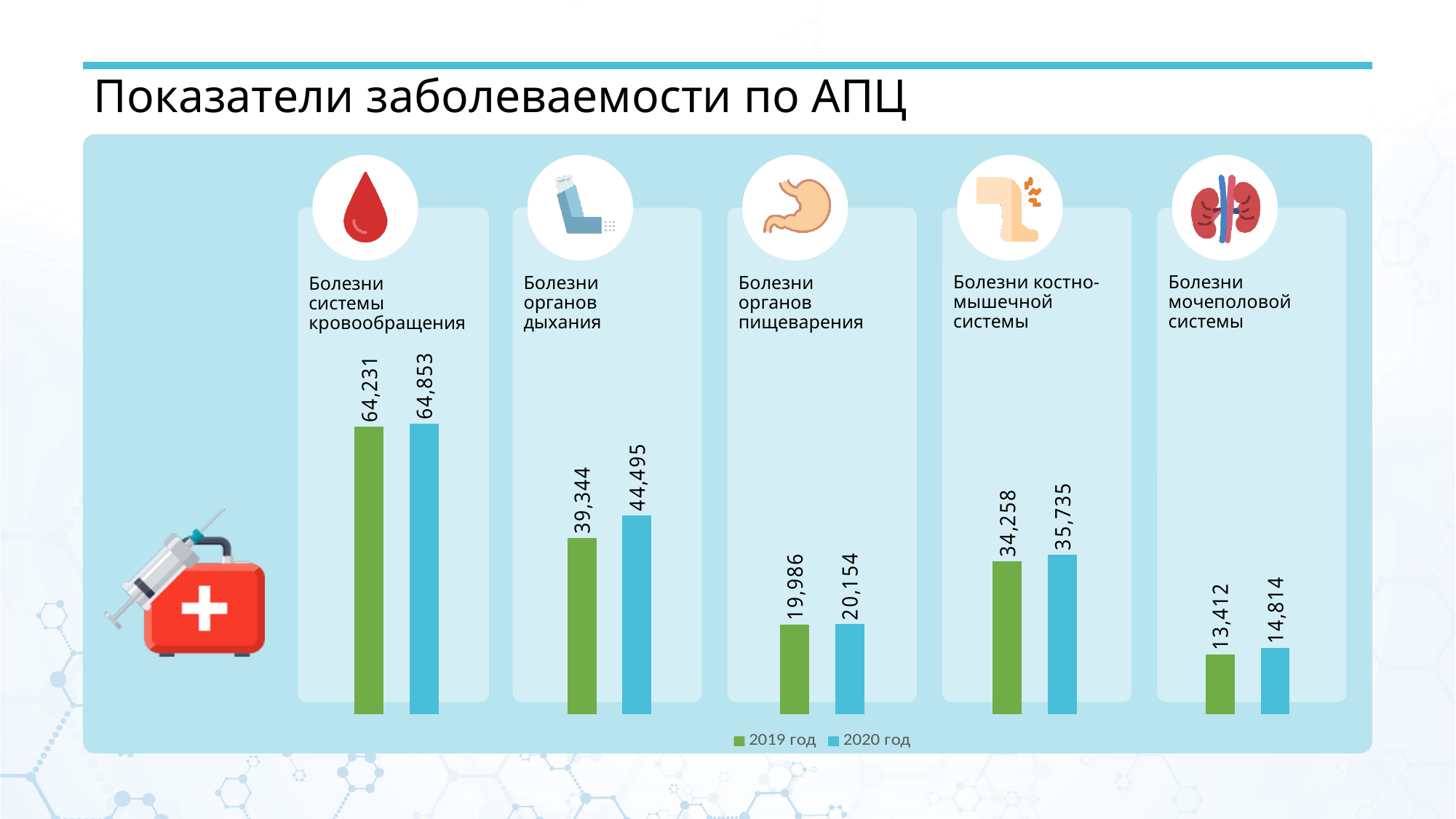
Which is larger for Болезни органов пищеварения: the 2019 год value or the 2020 год value? 2020 год Which category has the lowest 2019 год value? Болезни мочеполовой системы What is the 2020 год value for Болезни костно-мышечной системы? 35,735 How many series does the legend list? 2 What kind of chart is shown on the slide? Bar chart How many disease categories are shown in the chart? 5 Which category has the highest 2020 год value? Болезни системы кровообращения What is the 2019 год value for Болезни органов дыхания? 39,344 What is the difference between the 2020 год and 2019 год values for Болезни органов дыхания? 5,151 What is the 2020 год value for Болезни мочеполовой системы? 14,814 What is the difference between the 2020 год and 2019 год values for Болезни системы кровообращения? 622 Which colour represents 2019 год in the chart? Green